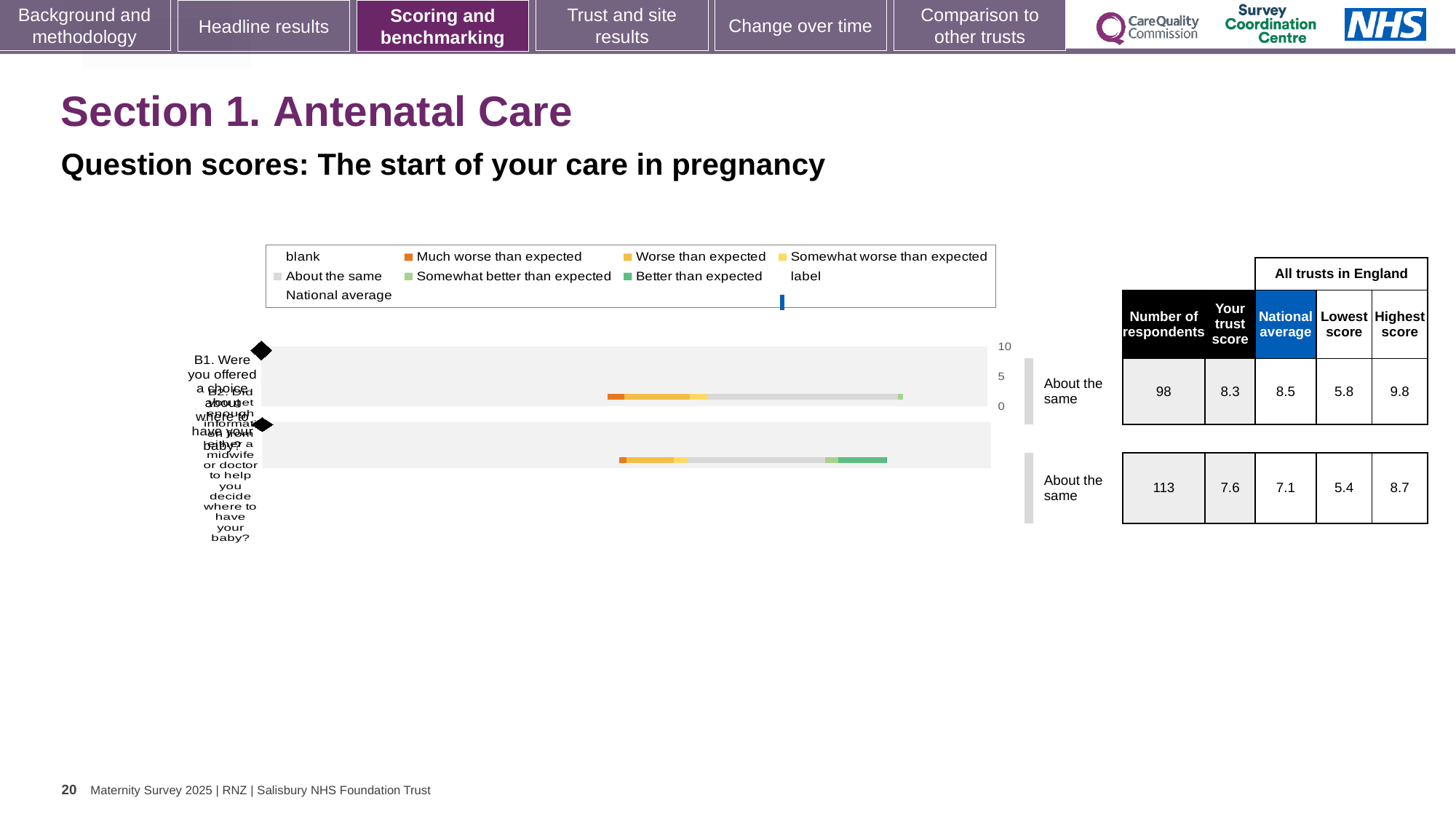
What is the highest score among all trusts in England for question B2? 8.7 What benchmark category is given for question B1 next to the chart? About the same For question B1, which is higher: the trust score or the national average? National average How many respondents answered question B1? 98 What is the national average for question B2 shown in the table beside the chart? 7.1 What does the blue marker in the chart legend represent? National average According to the table beside the chart, what is the trust score for question B1 (Were you offered a choice about where to have your baby?)? 8.3 What is the difference between the highest score (9.8) and the lowest score (5.8) for question B1? 4.0 How many survey questions (bars) are plotted in the chart? 2 What kind of chart is used to show the question scores on this slide? Bar chart For question B2, which is higher: the trust score or the national average? Your trust score By how much does the trust score for question B2 exceed the national average? 0.5